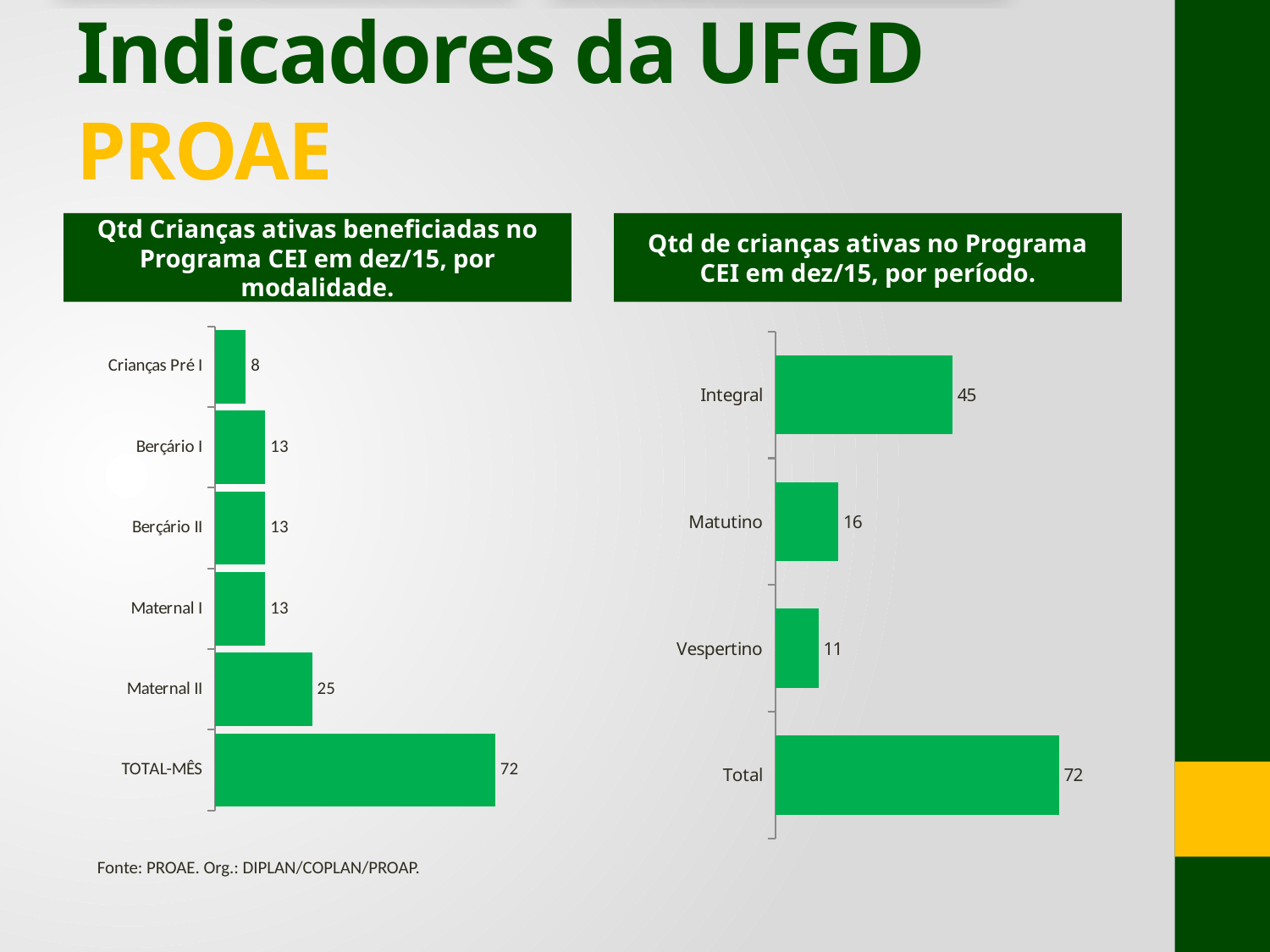
In the left chart (by modalidade), what is the value for Crianças Pré I? 8 In the right chart (by período), how many categories are shown? 4 What type of chart is the right chart (by período)? Bar chart In the right chart (by período), what is the value for Integral? 45 In the left chart (by modalidade), how many categories are shown? 6 In the left chart (by modalidade), what is the difference between Maternal II and Berçário I? 12 In the left chart (by modalidade), which category has the lowest value? Crianças Pré I In the right chart (by período), what is the value for Vespertino? 11 In the left chart (by modalidade), what is the value for Maternal II? 25 In the right chart (by período), what is the difference between Integral and Matutino? 29 In the right chart (by período), which is larger, Matutino or Vespertino? Matutino In the left chart (by modalidade), what is the value for TOTAL-MÊS? 72